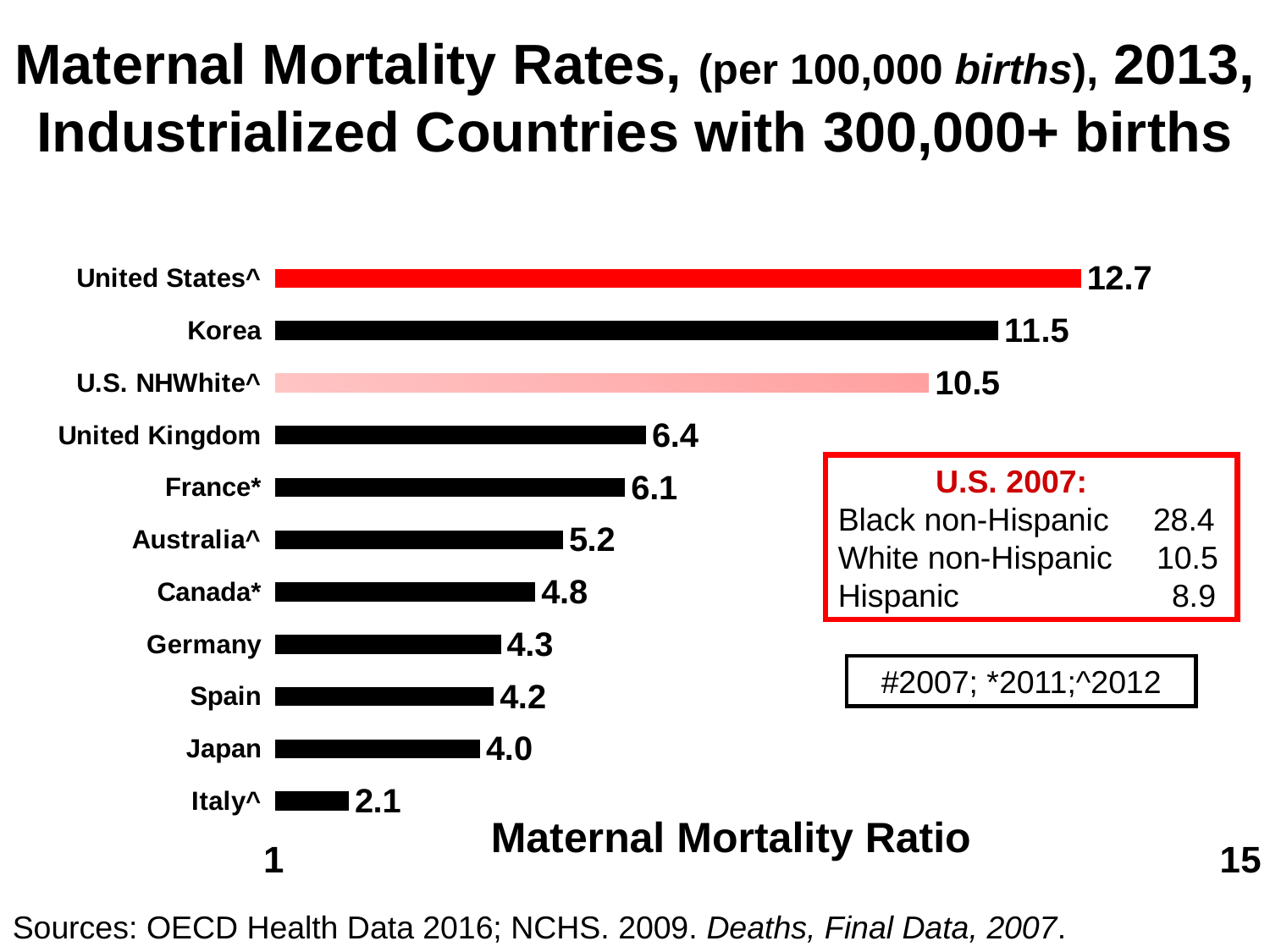
What is the maternal mortality rate shown for Korea? 11.5 Which has a higher value, Germany or U.S. NHWhite^? U.S. NHWhite^ How many categories (bars) are shown on the chart? 11 What is the value shown for the United Kingdom? 6.4 What is the value shown for Italy^? 2.1 Which category has the highest maternal mortality rate on the chart? United States^ Which category has the lowest maternal mortality rate on the chart? Italy^ What is the difference between the values for France* and Japan? 2.1 What is the x-axis title of the chart? Maternal Mortality Ratio What is the difference between the values for the United States^ and Korea? 1.2 Which has a higher value, Australia^ or Canada*? Australia^ What kind of chart is shown on the slide? Bar chart